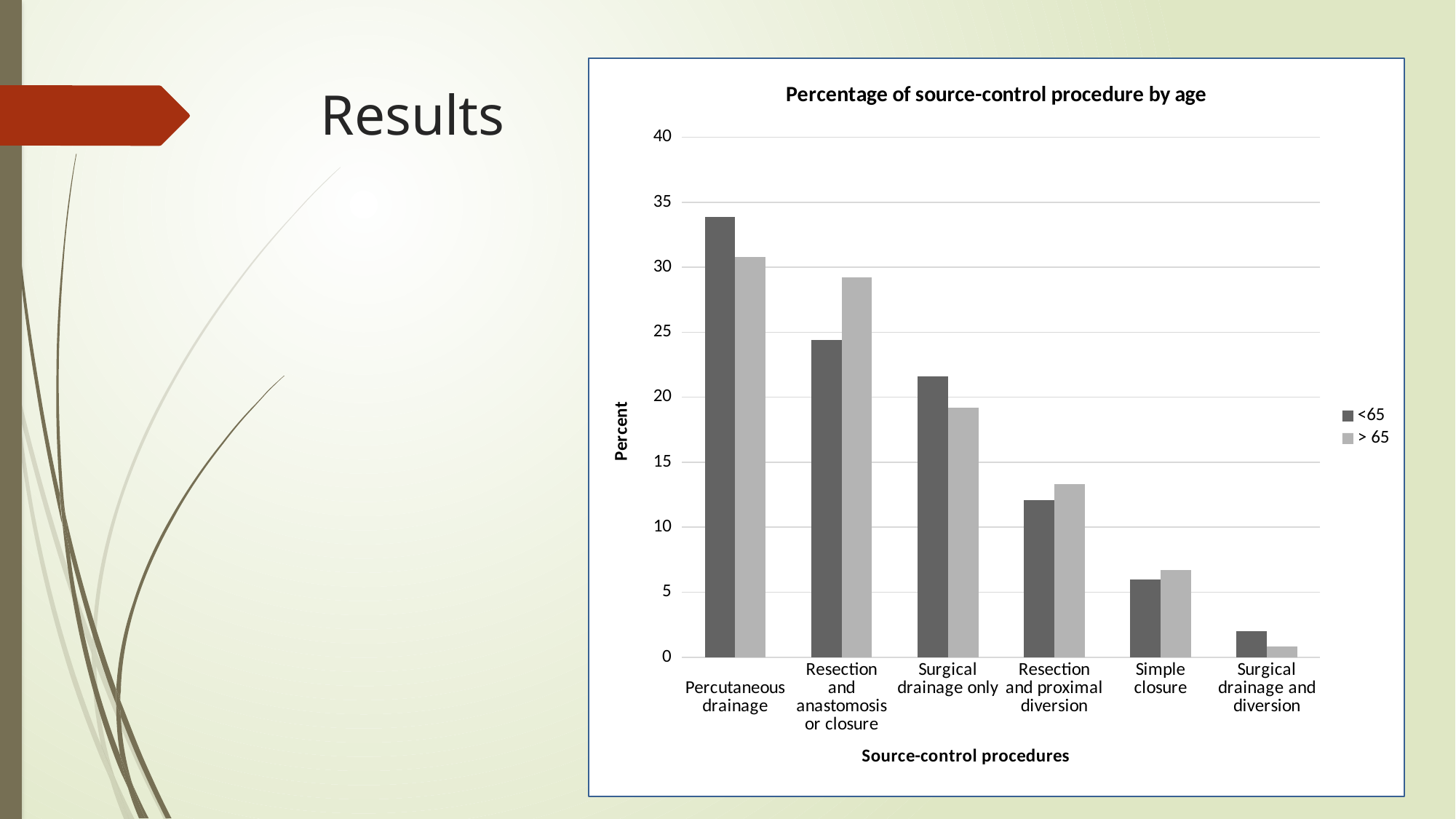
Which procedure has the highest value for the <65 series? Percutaneous drainage Is the value for Surgical drainage only in the > 65 series greater or less than 20? less For Surgical drainage only, which series has the larger value, <65 or > 65? <65 Which procedure has the lowest value for the > 65 series? Surgical drainage and diversion Is the value for Resection and anastomosis or closure in the <65 series greater or less than 25? less For Resection and anastomosis or closure, which series has the larger value, <65 or > 65? > 65 Do the values for the <65 series rise or fall moving left to right across the x axis? fall How many series does the legend list? 2 What is the title of the chart? Percentage of source-control procedure by age What kind of chart is shown on the slide? bar chart Is the value for Percutaneous drainage in the <65 series greater or less than 30? greater How many source-control procedure categories are shown on the x axis? 6